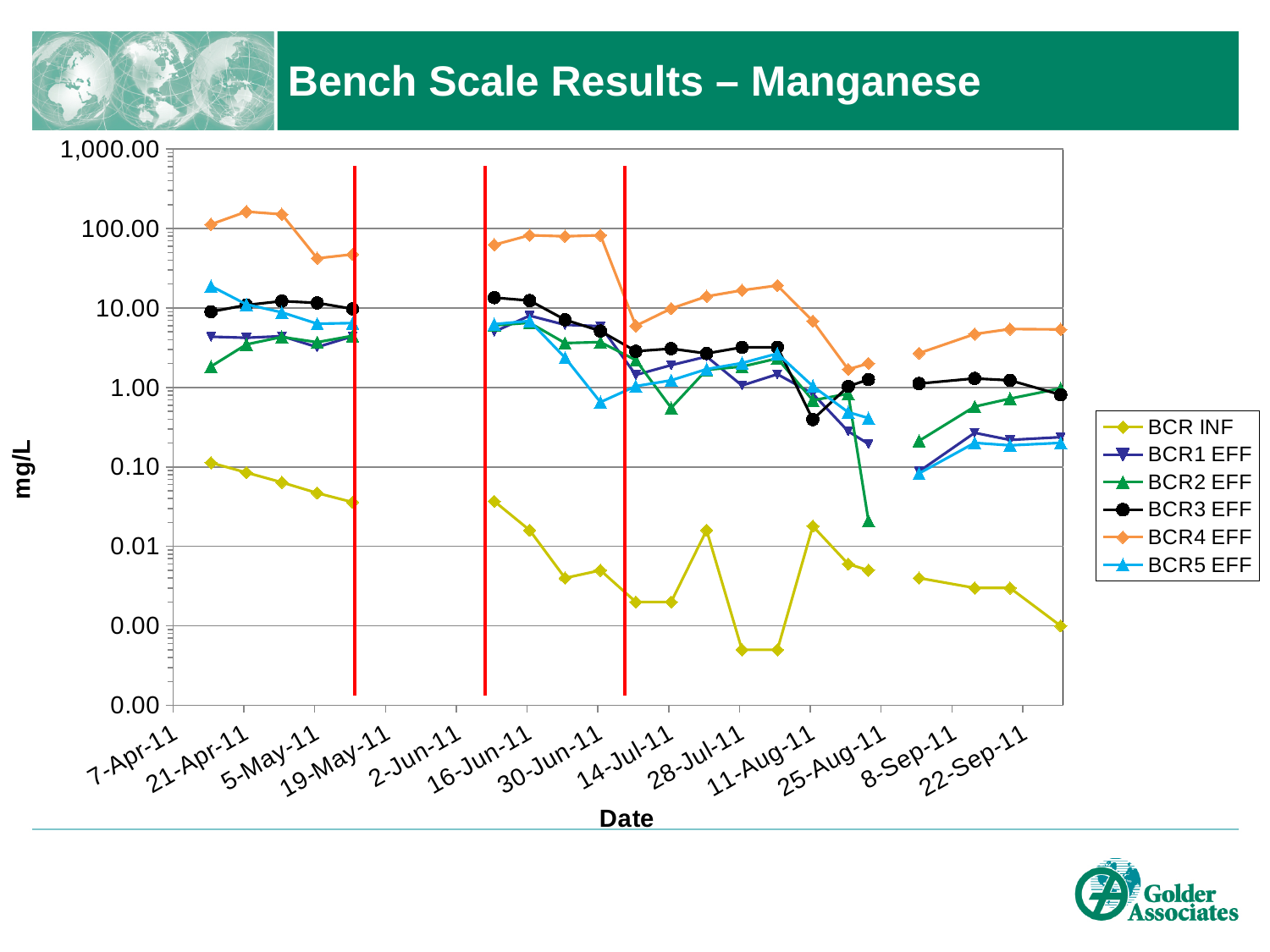
What kind of chart is shown on the slide? line chart Is the value for BCR INF on 5-May-11 greater or less than 0.10? less Is the value for BCR3 EFF on 16-Jun-11 greater or less than 10? greater Which series has the lowest value on 21-Apr-11? BCR INF What is the title of the chart? Bench Scale Results – Manganese Which series has the highest value on 21-Apr-11? BCR4 EFF What is the label on the y axis of the chart? mg/L Is the value for BCR4 EFF on 21-Apr-11 greater or less than 100? greater Do the values for BCR INF rise or fall from 7-Apr-11 to 19-May-11? fall How many series does the legend list? 6 Which is larger on 16-Jun-11, the value for BCR4 EFF or the value for BCR INF? BCR4 EFF